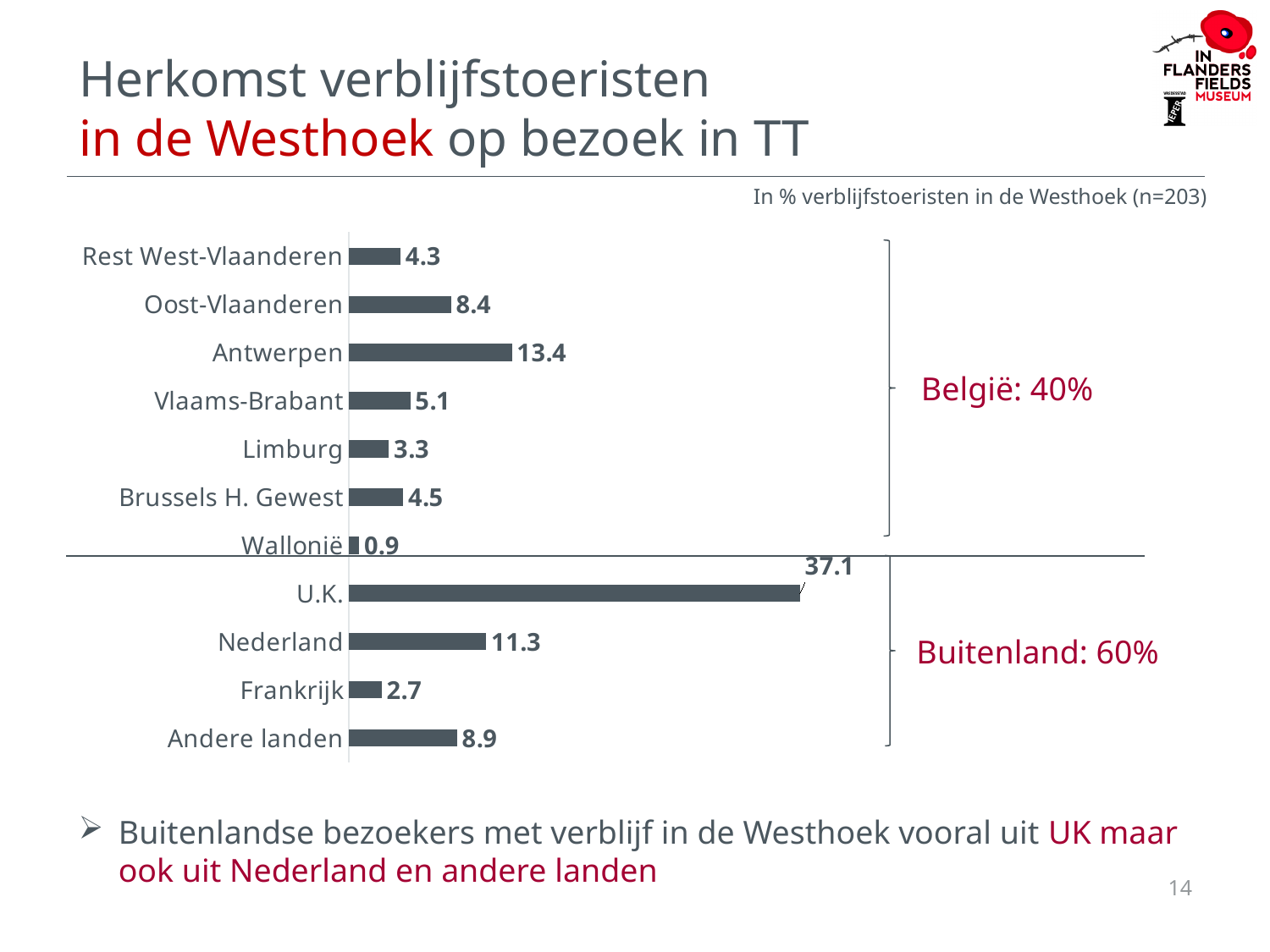
What is the value for Antwerpen? 13.4 What is the value for Wallonië? 0.9 How many categories are shown in the chart? 11 Which category has the lowest value? Wallonië Which is larger, the value for Oost-Vlaanderen or the value for Andere landen? Andere landen What is the sample size (n) stated on the slide? 203 What is the difference between the values for U.K. and Nederland? 25.8 What is the difference between the values for Antwerpen and Limburg? 10.1 Which category has the highest value? U.K. What kind of chart is shown on the slide? Bar chart What share of verblijfstoeristen comes from Buitenland according to the annotation? 60% What is the value for U.K.? 37.1